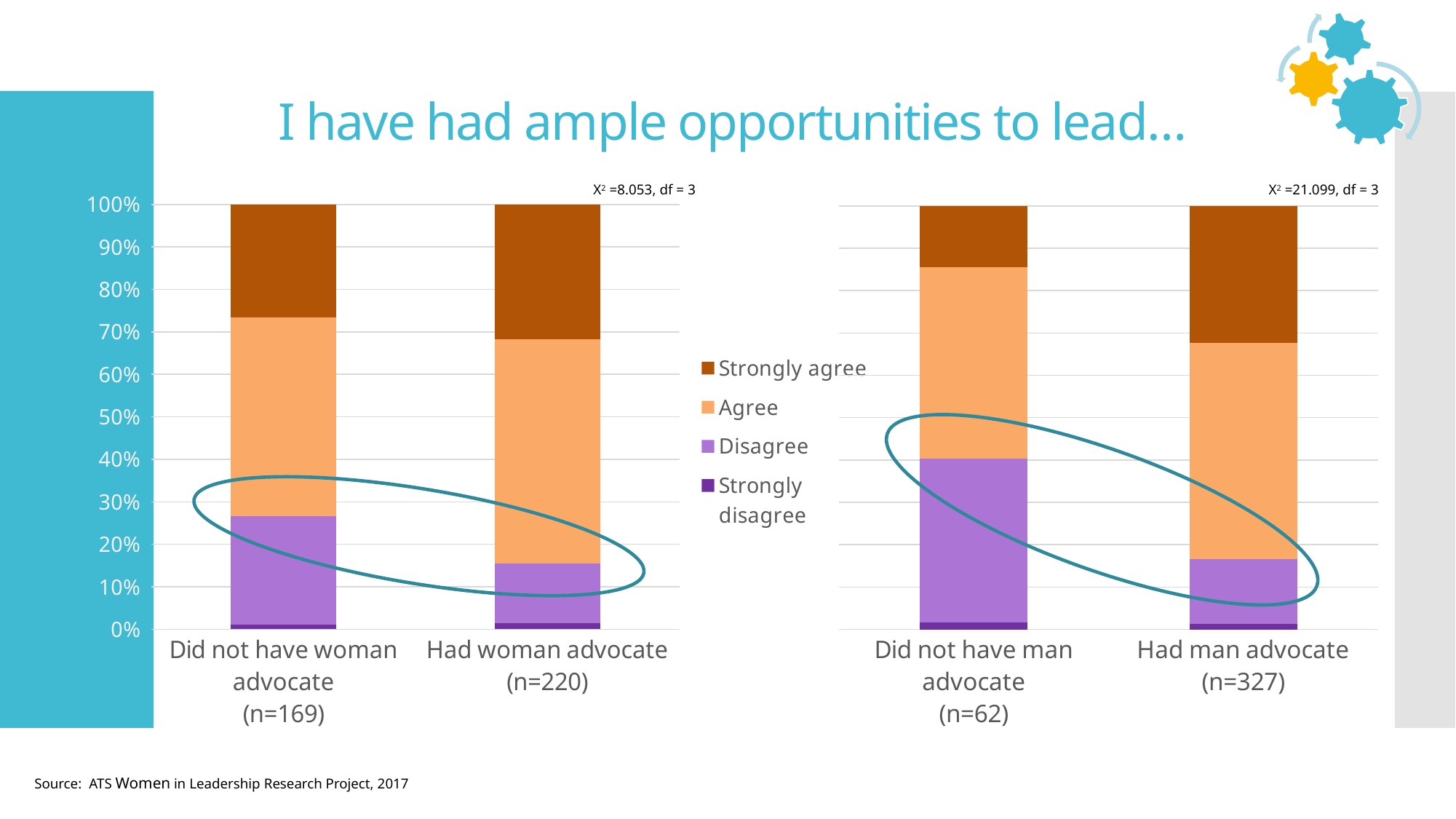
How many series does the legend list? 4 In the left chart (woman advocate), which category has the larger Disagree segment? Did not have woman advocate In the right chart, is the combined share of Disagree and Strongly disagree for 'Did not have man advocate' greater or less than 30%? greater In the right chart, is the Strongly agree share for 'Did not have man advocate' greater or less than 20%? less What is the title of the slide? I have had ample opportunities to lead… In the right chart, is the combined share of Disagree and Strongly disagree for 'Had man advocate' greater or less than 20%? less What is the sample size (n) shown for the 'Had man advocate' category in the right chart? n=327 In the right chart (man advocate), which category has the larger Disagree segment? Did not have man advocate How many categories are plotted in the left chart (woman advocate)? 2 What kind of chart is shown on the left side of the slide? Stacked bar chart